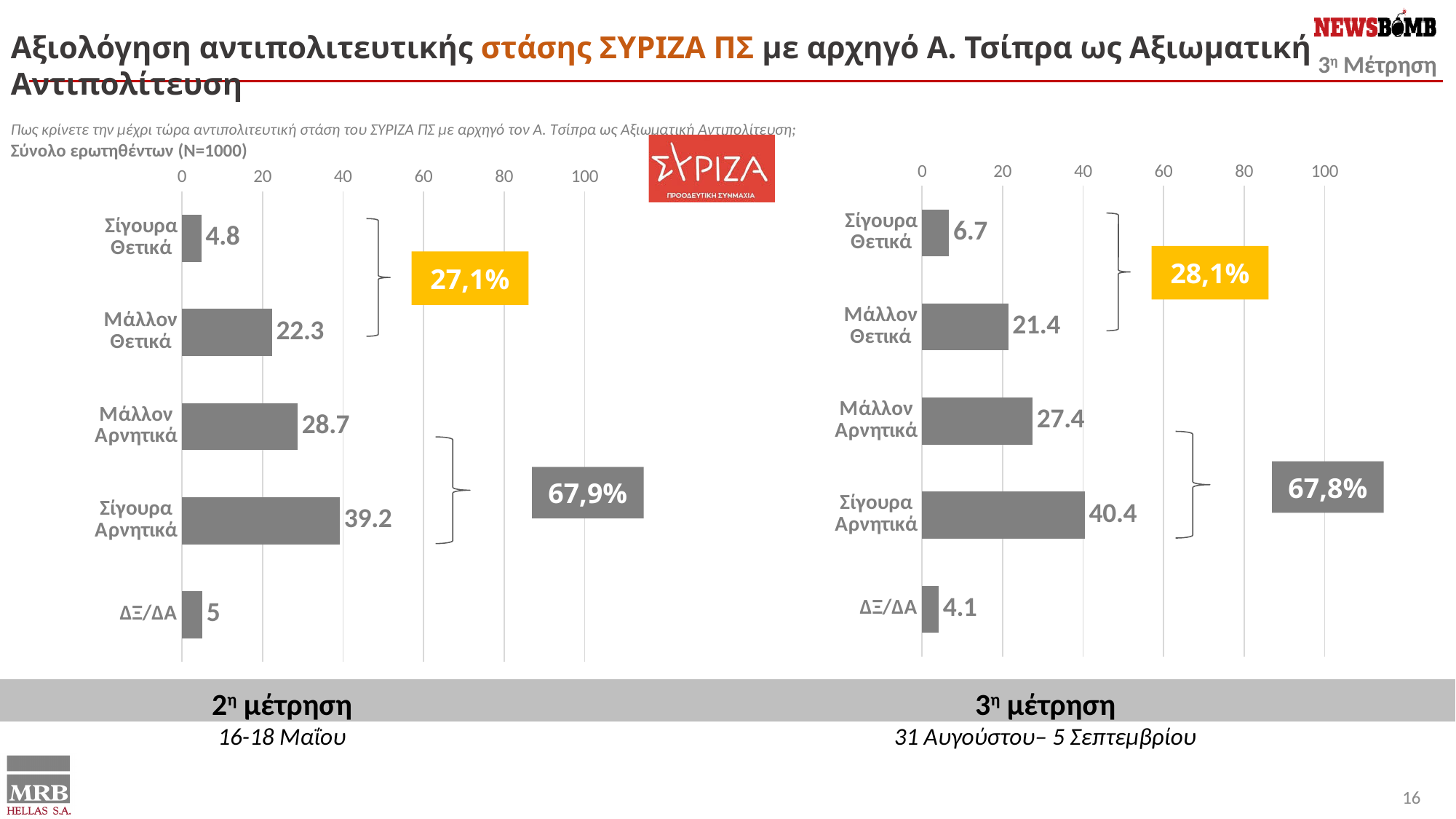
In the left chart (2η μέτρηση), what is the difference between Σίγουρα Αρνητικά and Μάλλον Αρνητικά? 10.5 In the right chart (3η μέτρηση), what percentage is shown in the yellow box for the combined positive responses? 28,1% In the right chart (3η μέτρηση), what is the value for Σίγουρα Θετικά? 6.7 In the right chart (3η μέτρηση), which category has the lowest value? ΔΞ/ΔΑ In the right chart (3η μέτρηση), is the value for Σίγουρα Αρνητικά greater or less than 40? greater In the right chart (3η μέτρηση), what is the difference between Μάλλον Θετικά and Σίγουρα Θετικά? 14.7 What kind of chart is the right chart (3η μέτρηση)? Bar chart In the left chart (2η μέτρηση), which category has the highest value? Σίγουρα Αρνητικά How many categories are shown in the left chart (2η μέτρηση)? 5 Which is larger: Μάλλον Θετικά in the left chart (2η μέτρηση) or Μάλλον Θετικά in the right chart (3η μέτρηση)? Left chart (2η μέτρηση) In the left chart (2η μέτρηση), what is the value for Σίγουρα Αρνητικά? 39.2 In the right chart (3η μέτρηση), what is the value for ΔΞ/ΔΑ? 4.1